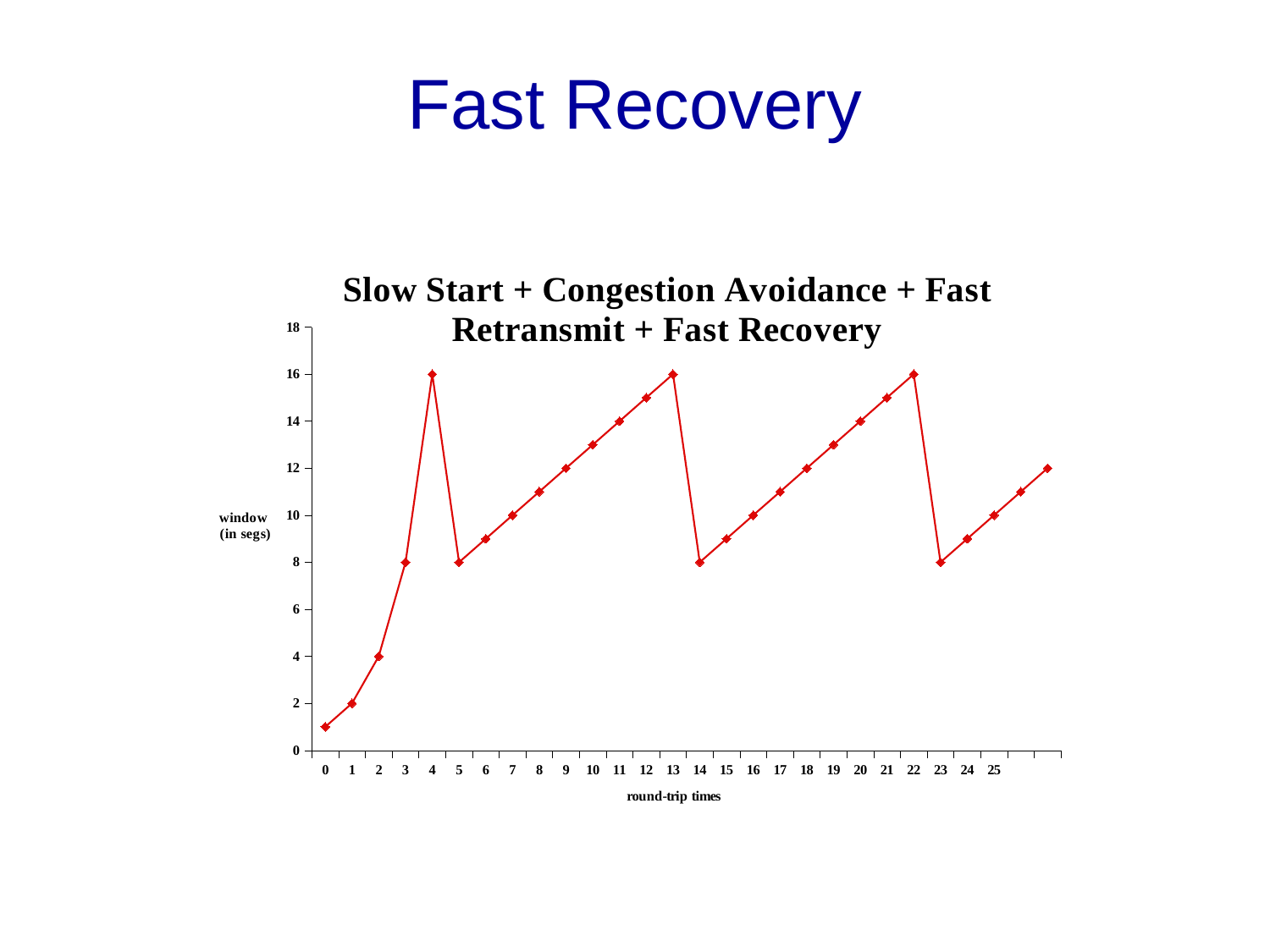
Which is larger, the window size at round-trip time 13 or at round-trip time 14? round-trip time 13 What is the window size (in segs) at round-trip time 4? 16 Is the window size at round-trip time 20 greater or less than 12? greater What is the label of the x axis? round-trip times What type of chart is shown on the slide? line chart Is the window size at round-trip time 0 greater or less than 2? less What is the highest window size reached on the chart? 16 What is the window size (in segs) at round-trip time 2? 4 What is the window size (in segs) at round-trip time 22? 16 What is the window size (in segs) at round-trip time 5? 8 What is the window size (in segs) at round-trip time 14? 8 By how much does the window size drop between round-trip time 4 and round-trip time 5? 8